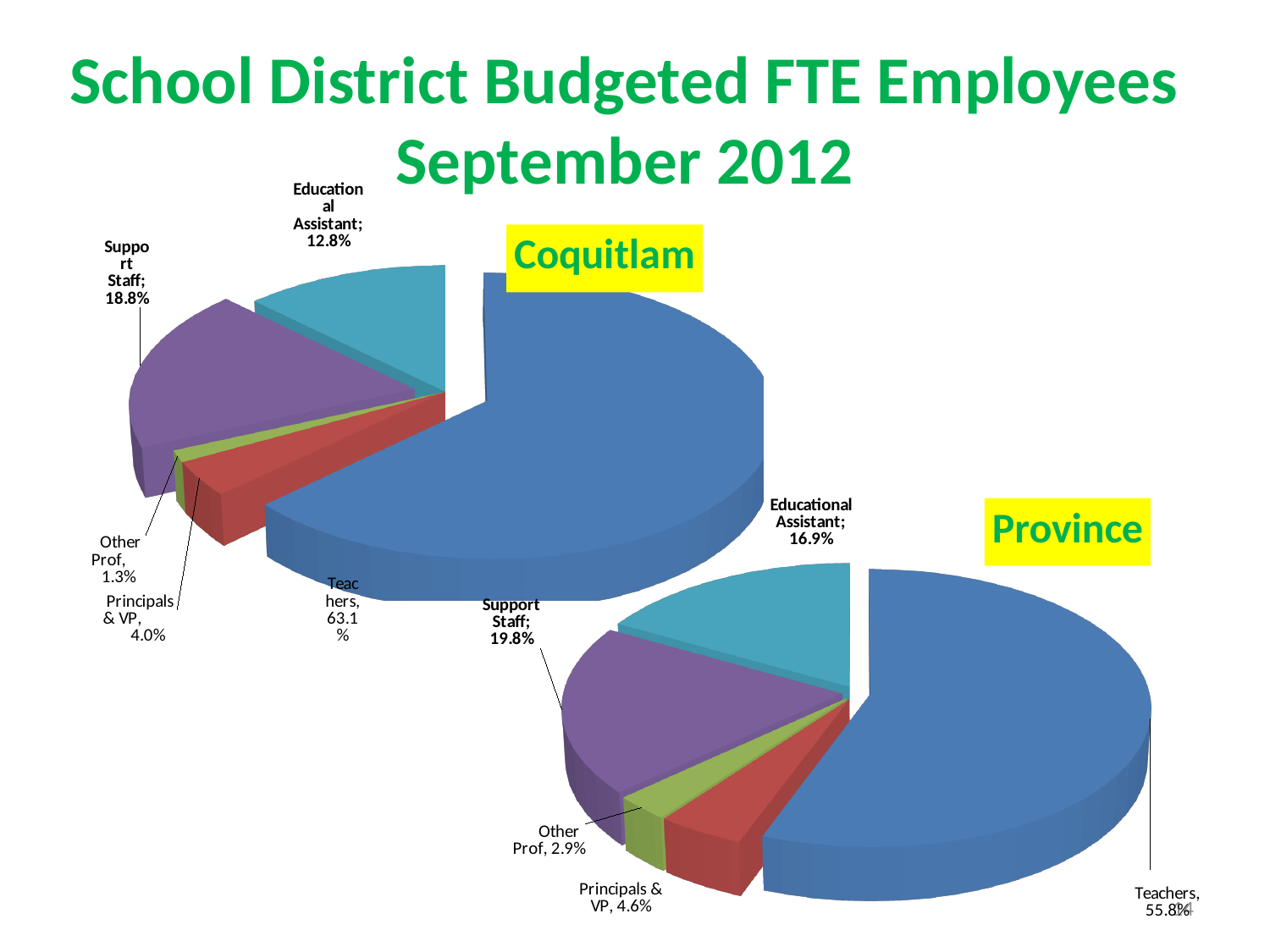
In the Coquitlam chart, what share does Support Staff have? 18.8% In the Coquitlam chart, which category has the smallest share? Other Prof In the Province chart, which category has the largest share? Teachers In the Coquitlam chart, what share do Teachers have? 63.1% In the Province chart, what share does Educational Assistant have? 16.9% What kind of chart is the Coquitlam chart? pie chart In the Province chart, what share does Support Staff have? 19.8% In the Province chart, what is the difference between the Support Staff share and the Other Prof share? 16.9% In the Province chart, what share do Principals & VP have? 4.6% In the Coquitlam chart, how many slices are there? 5 Which chart has the larger Educational Assistant share, Coquitlam or Province? Province In the Coquitlam chart, what share does Educational Assistant have? 12.8%